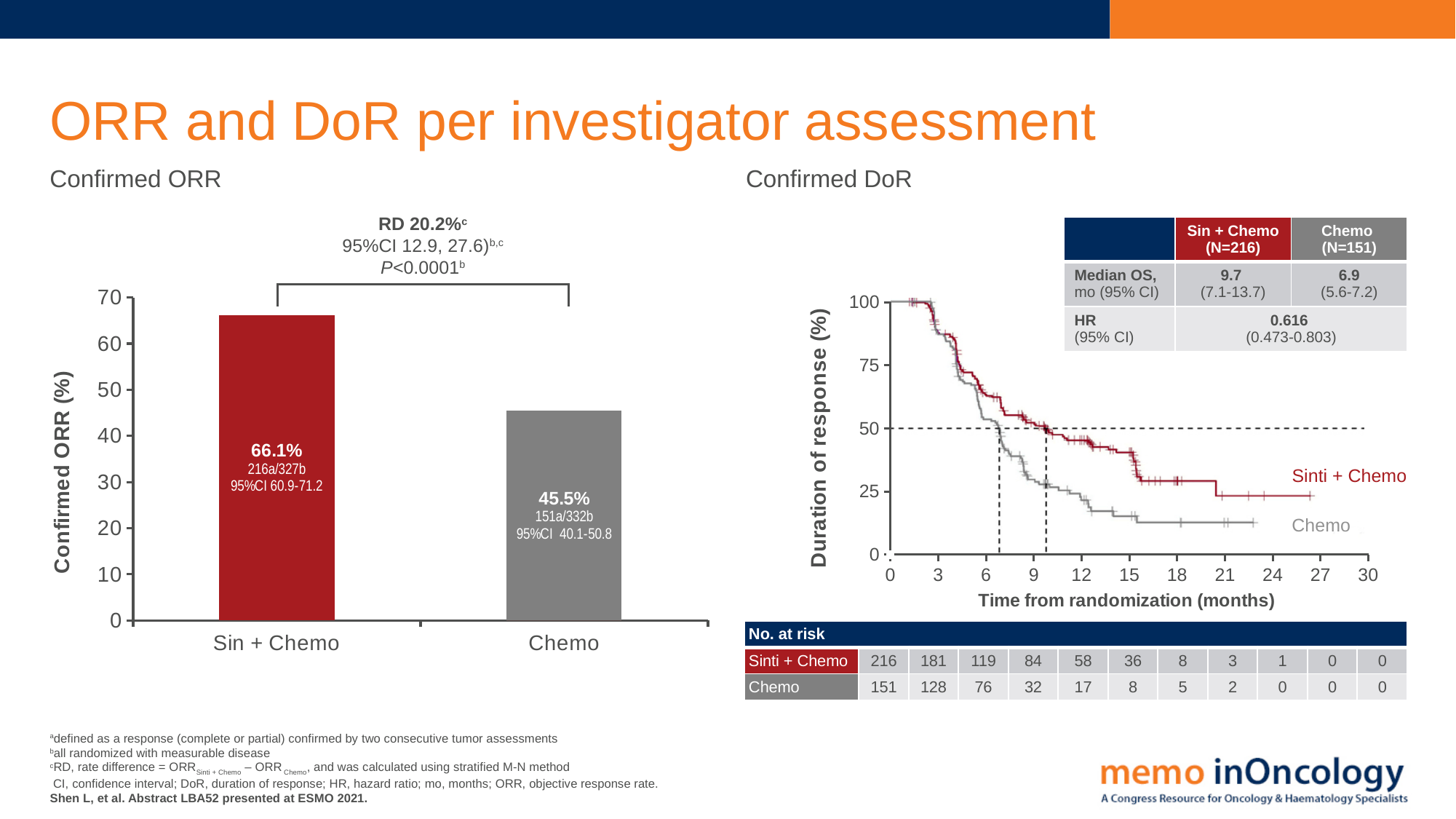
On the Confirmed DoR chart, is the Chemo curve at 18 months greater or less than 25%? less On the Confirmed ORR bar chart, what is the 95% CI shown for the Chemo arm? 40.1-50.8 On the Confirmed ORR bar chart, what rate difference (RD) is shown above the bars? RD 20.2% On the Confirmed ORR bar chart, what is the confirmed ORR for Sin + Chemo? 66.1% On the Confirmed DoR chart, how many patients were at risk in the Chemo arm at 9 months? 32 On the Confirmed DoR chart, how many curves (arms) are plotted? 2 On the Confirmed ORR bar chart, how many bars are plotted? 2 On the Confirmed DoR chart, what is the median duration of response for Sin + Chemo? 9.7 On the Confirmed DoR chart, what is the hazard ratio shown in the table? 0.616 What type of chart is the Confirmed ORR chart on the left? Bar chart On the Confirmed ORR bar chart, what is the confirmed ORR for Chemo? 45.5% On the Confirmed ORR bar chart, which arm has the higher confirmed ORR? Sin + Chemo